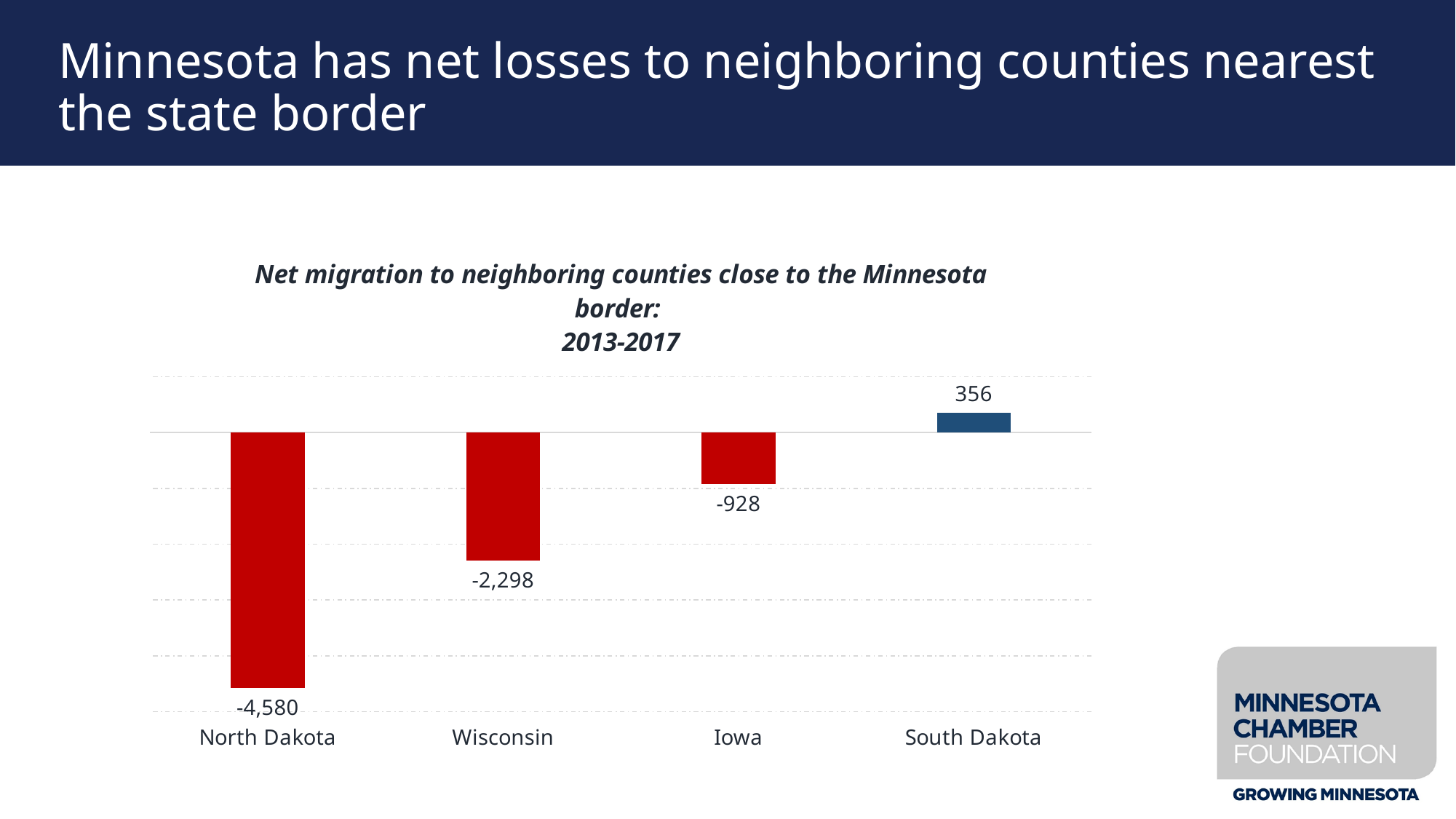
What is the net migration value for South Dakota? 356 What time period does the chart title say the data covers? 2013-2017 What is the difference between the net migration values for Wisconsin and Iowa? 1,370 What is the net migration value for North Dakota? -4,580 Which state has the highest net migration value? South Dakota What is the net migration value for Iowa? -928 What kind of chart is shown on the slide? Bar chart How many states are shown on the chart? 4 Which state is the only one with a positive net migration value? South Dakota Which state has the lowest net migration value? North Dakota What is the net migration value for Wisconsin? -2,298 Which has a larger net migration value, Iowa or Wisconsin? Iowa